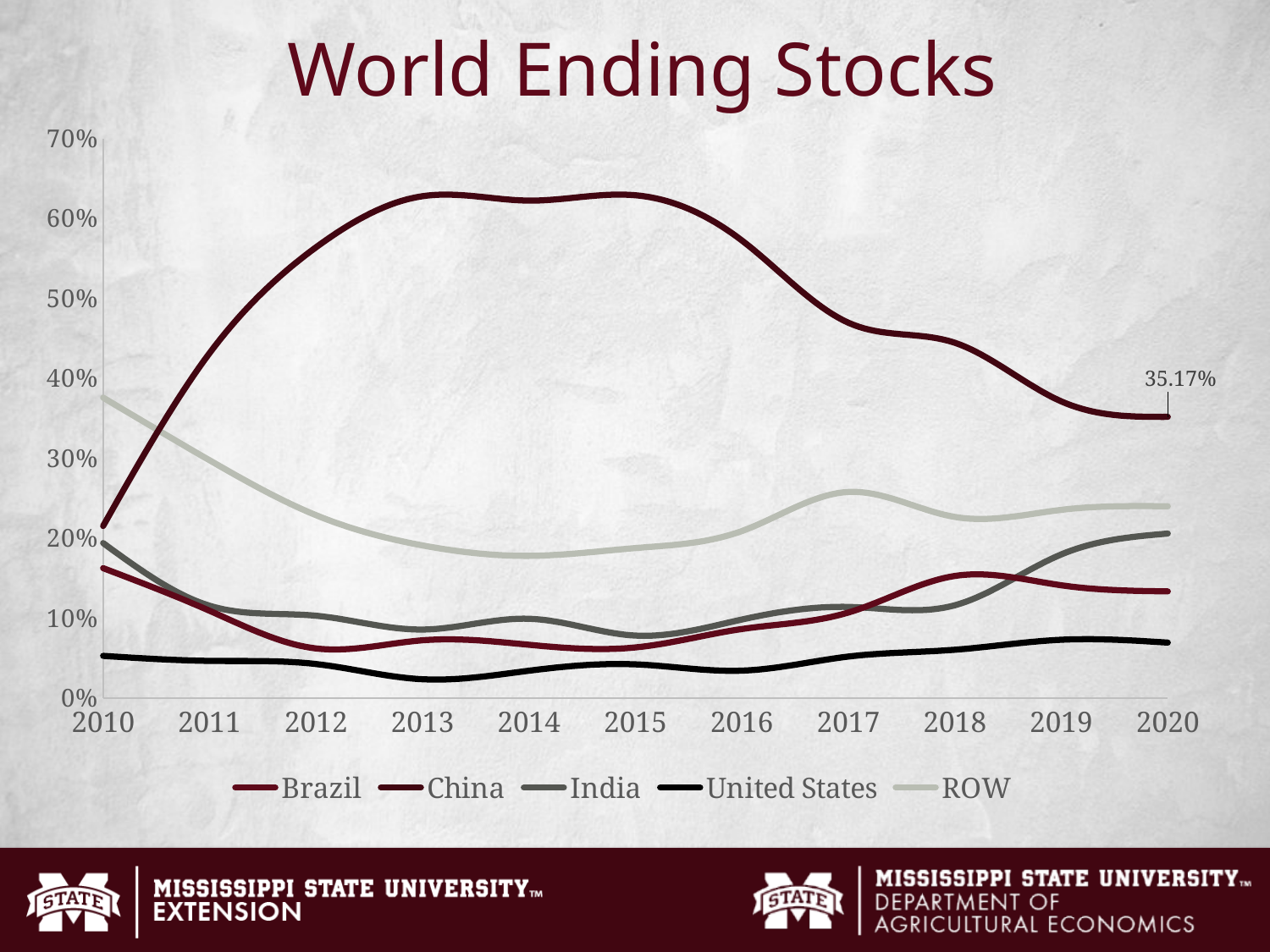
What kind of chart is shown on the slide? line chart Does the value for China rise or fall from 2015 to 2020? fall How many series does the legend list? 5 How many years are shown along the x axis? 11 In 2010, which is larger: the value for ROW or the value for China? ROW Is the value for ROW in 2010 greater or less than 30%? greater Is the value for China in 2013 greater or less than 60%? greater Which series has the highest value in 2020? China Is the value for United States in 2013 greater or less than 10%? less Which series has the lowest value in 2020? United States What is the title of the chart? World Ending Stocks What is the value for China in 2020? 35.17%